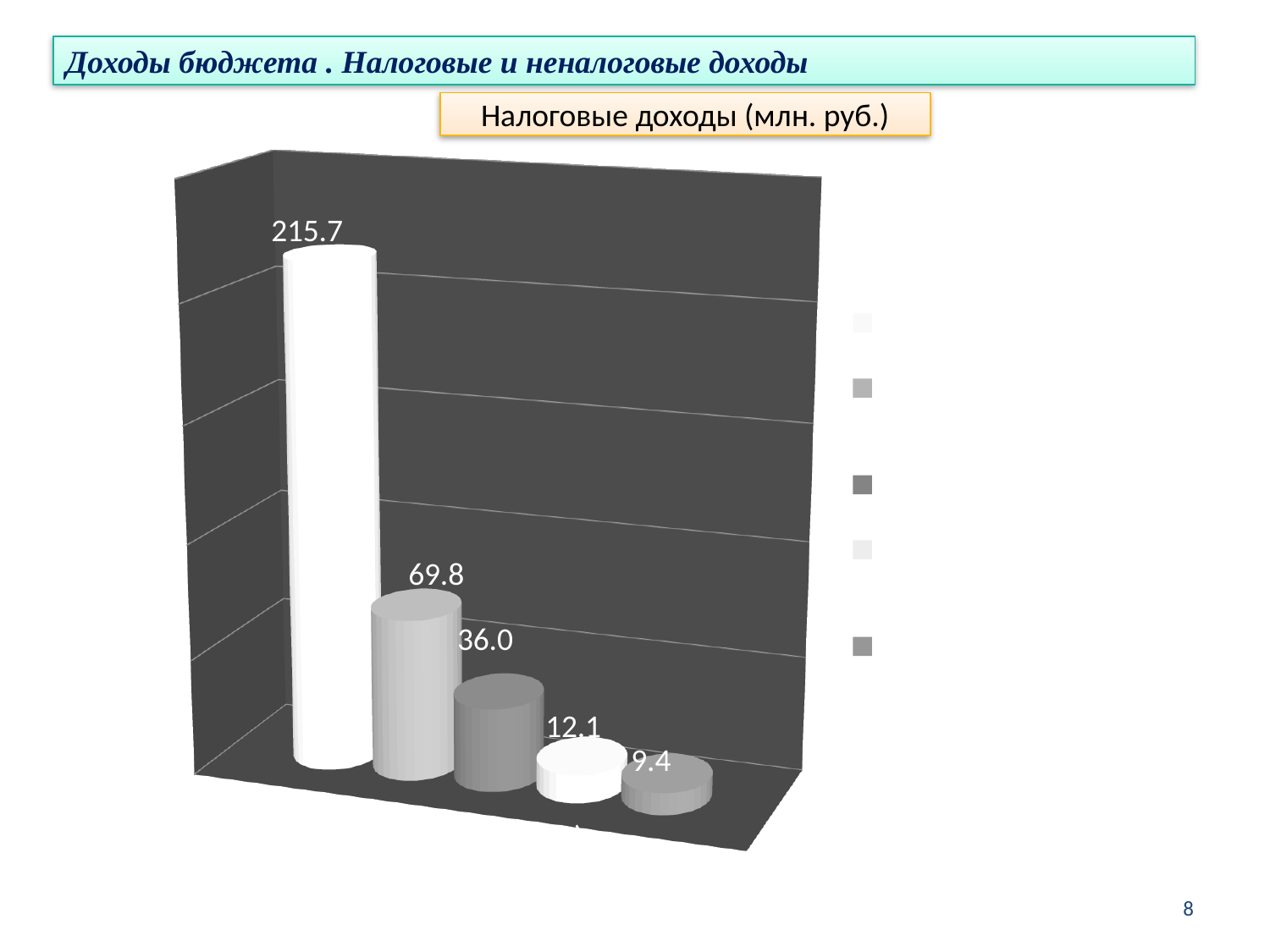
What is the lowest value shown in the chart? 9.4 What is the value of the second bar from the left? 69.8 What is the difference between the tallest bar (215.7) and the second tallest bar (69.8)? 145.9 What kind of chart is shown on the slide? bar chart How many bars are plotted in the chart? 5 What is the difference between the two smallest bars (12.1 and 9.4)? 2.7 How many entries does the legend show? 5 What is the highest value shown in the chart? 215.7 What is the title of the chart? Налоговые доходы (млн. руб.) What is the value of the tallest (leftmost) bar? 215.7 What is the value of the third bar from the left? 36.0 Do the bar values rise or fall from left to right? fall